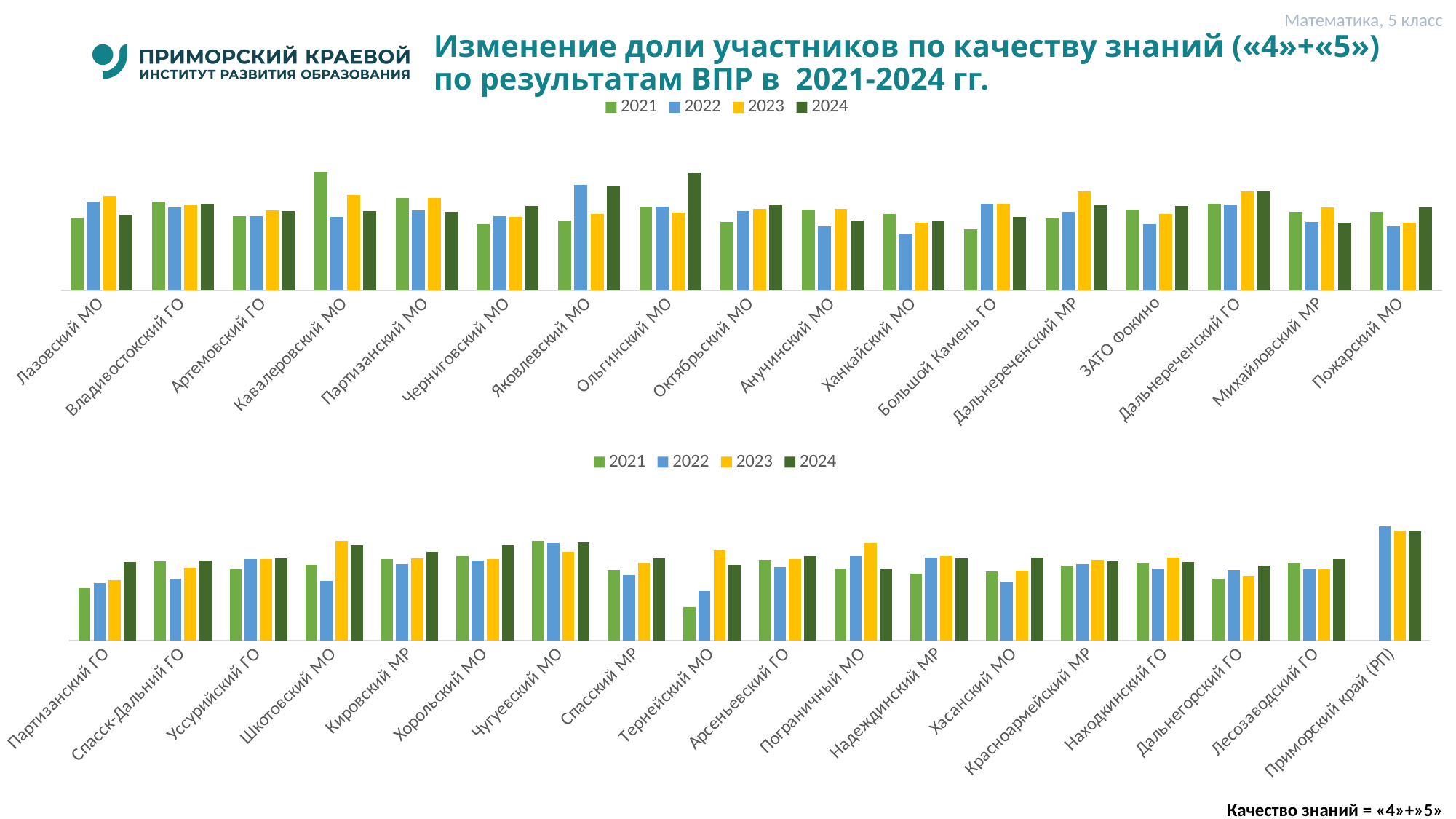
In the top chart, for Яковлевский МО, which is larger: the 2021 value or the 2022 value? 2022 In the bottom chart, which category has the lowest value for 2021? Тернейский МО In the top chart, which category has the highest value for 2022? Яковлевский МО In the bottom chart, which category has the highest value for 2022? Приморский край (РП) How many categories are shown on the x axis of the top chart? 17 How many categories are shown on the x axis of the bottom chart? 18 Which series is shown in yellow in the legend? 2023 In the bottom chart, do the values for Партизанский ГО rise or fall from 2021 to 2024? Rise In the top chart, which category has the highest value for 2024? Ольгинский МО How many series does the legend of the top chart list? 4 What kind of chart is used on this slide? Bar chart